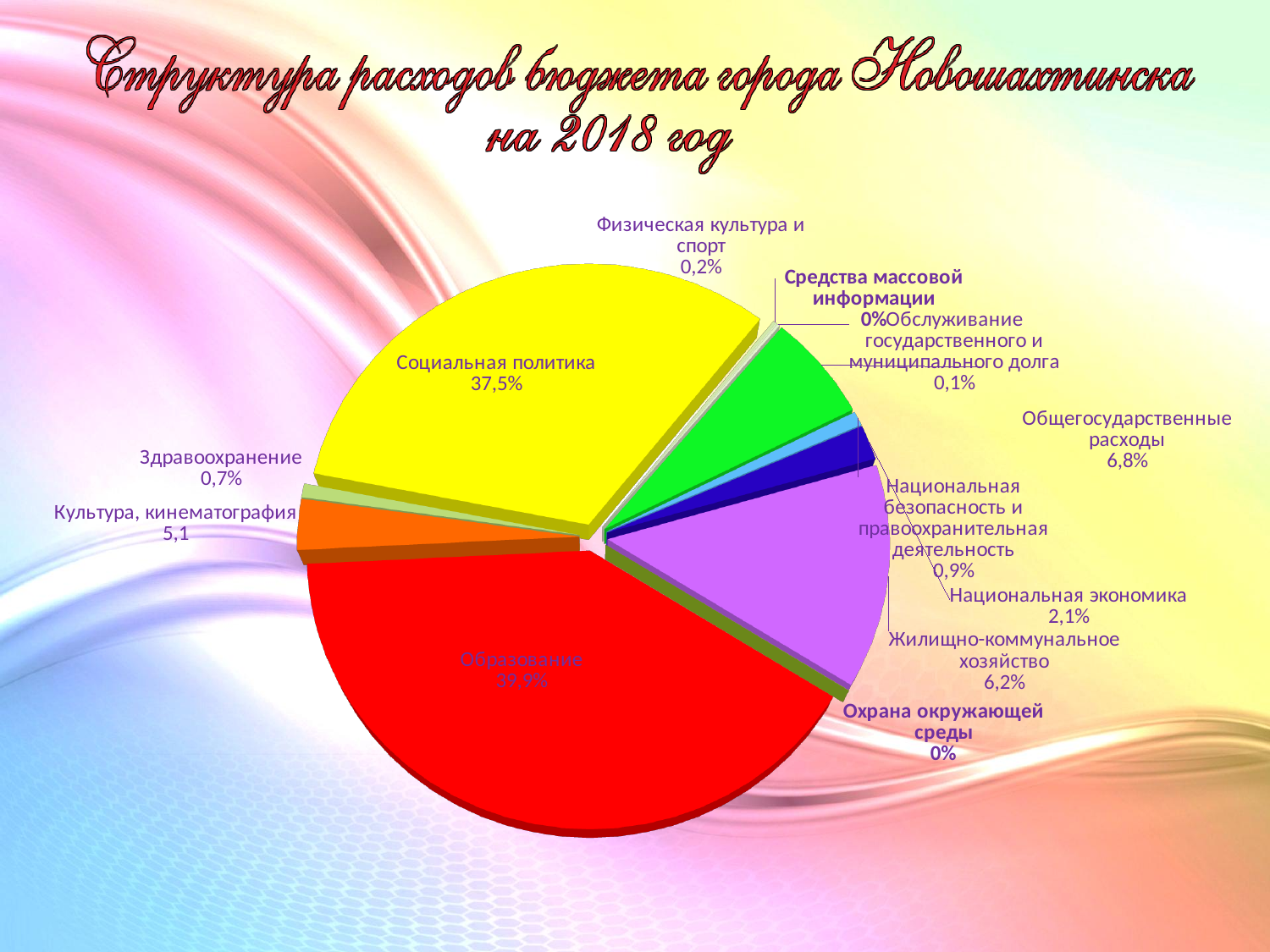
What is the share for Общегосударственные расходы? 6,8% What is the share for Социальная политика? 37,5% How many categories are labelled on the pie chart? 12 What is the share for Жилищно-коммунальное хозяйство? 6,2% What colour is the Образование slice? Red What is the share for Здравоохранение? 0,7% What is the share for Образование? 39,9% Which category has the largest share of the pie? Образование What kind of chart is shown on the slide? Pie chart What is the share for Национальная экономика? 2,1% By how many percentage points does Образование exceed Социальная политика? 2,4